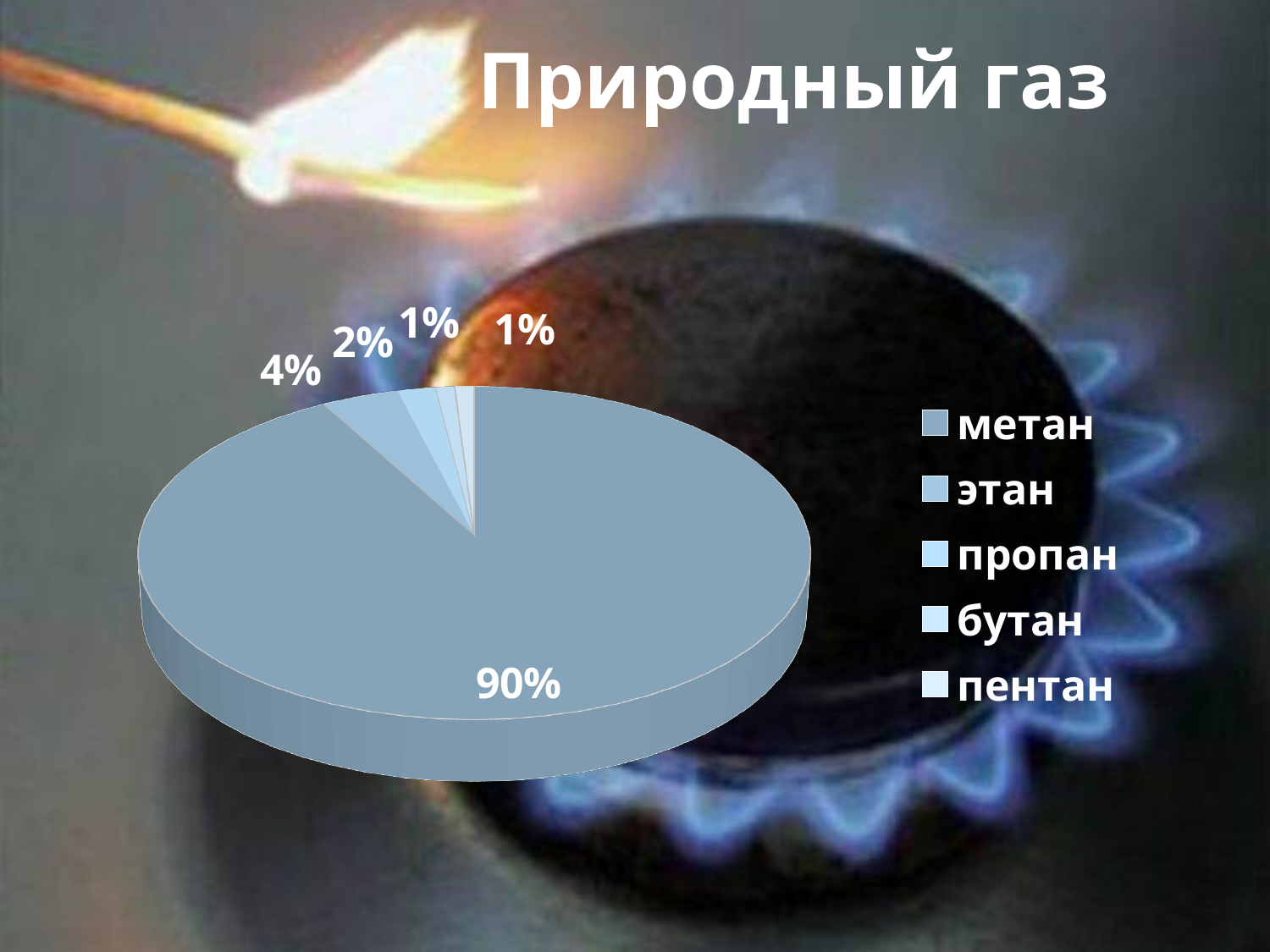
Which is larger, the slice for этан or the slice for пропан? этан What is the value shown for этан? 4% What is the difference between the values for метан and этан? 86% What share of the pie does метан take? 90% What kind of chart is shown on the slide? pie chart Which category has the largest slice of the pie? метан How many categories does the pie chart show? 5 How many entries does the legend list? 5 What is the value shown for бутан? 1% What is the title of the chart on the slide? Природный газ Which legend entry is listed last? пентан What is the value shown for пропан? 2%